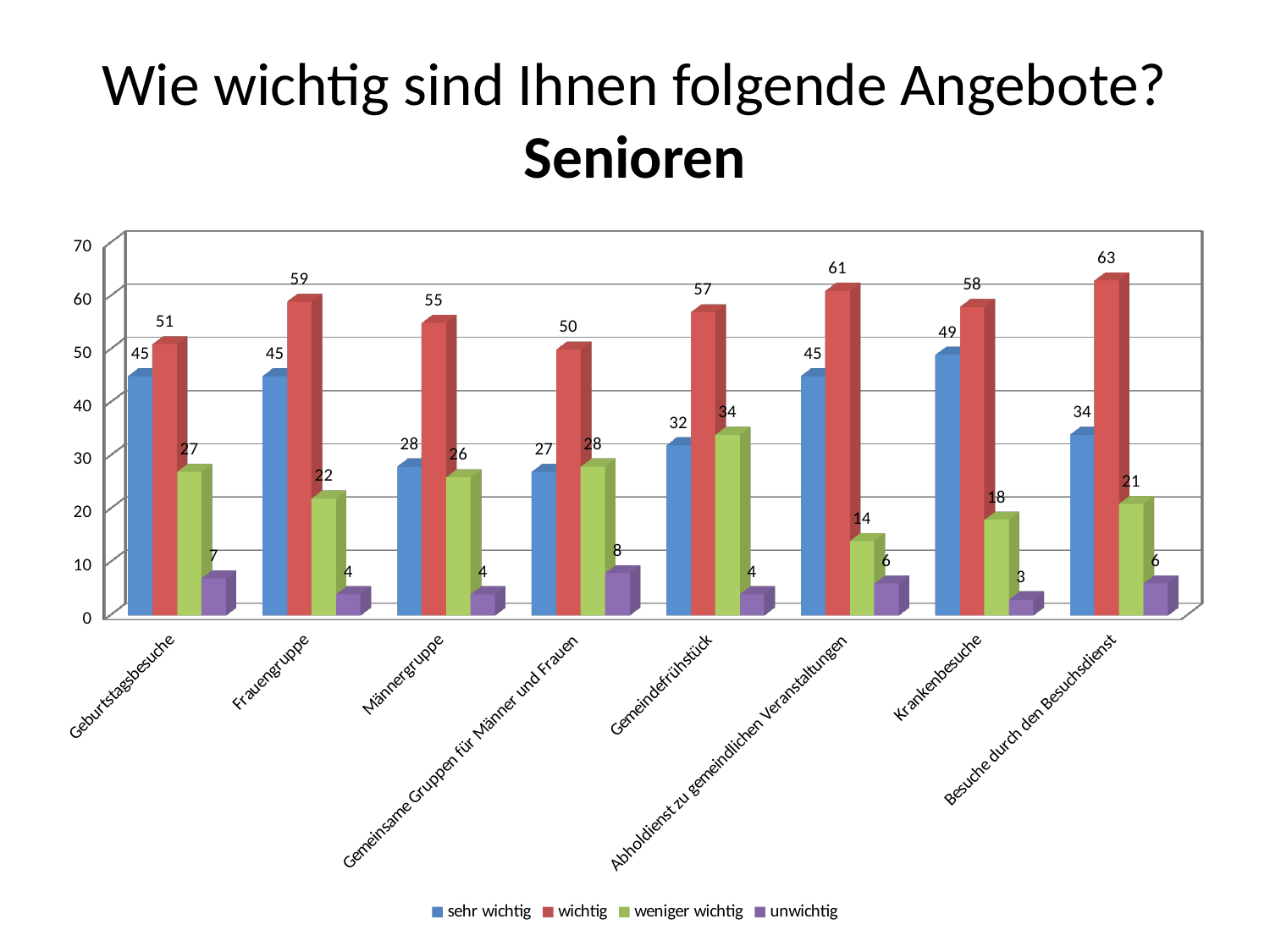
What is the difference between the "wichtig" and "sehr wichtig" values for Frauengruppe? 14 What is the value for "wichtig" for Besuche durch den Besuchsdienst? 63 What kind of chart is shown on the slide? bar chart How many series does the legend list? 4 What is the value for "sehr wichtig" for Krankenbesuche? 49 Which is larger for Gemeindefrühstück: "sehr wichtig" or "weniger wichtig"? weniger wichtig How many categories are shown on the x axis? 8 Which category has the lowest value for "unwichtig"? Krankenbesuche What is the value for "weniger wichtig" for Gemeindefrühstück? 34 Which category has the highest value for "wichtig"? Besuche durch den Besuchsdienst What is the value for "unwichtig" for Gemeinsame Gruppen für Männer und Frauen? 8 Which colour represents the "unwichtig" series? purple